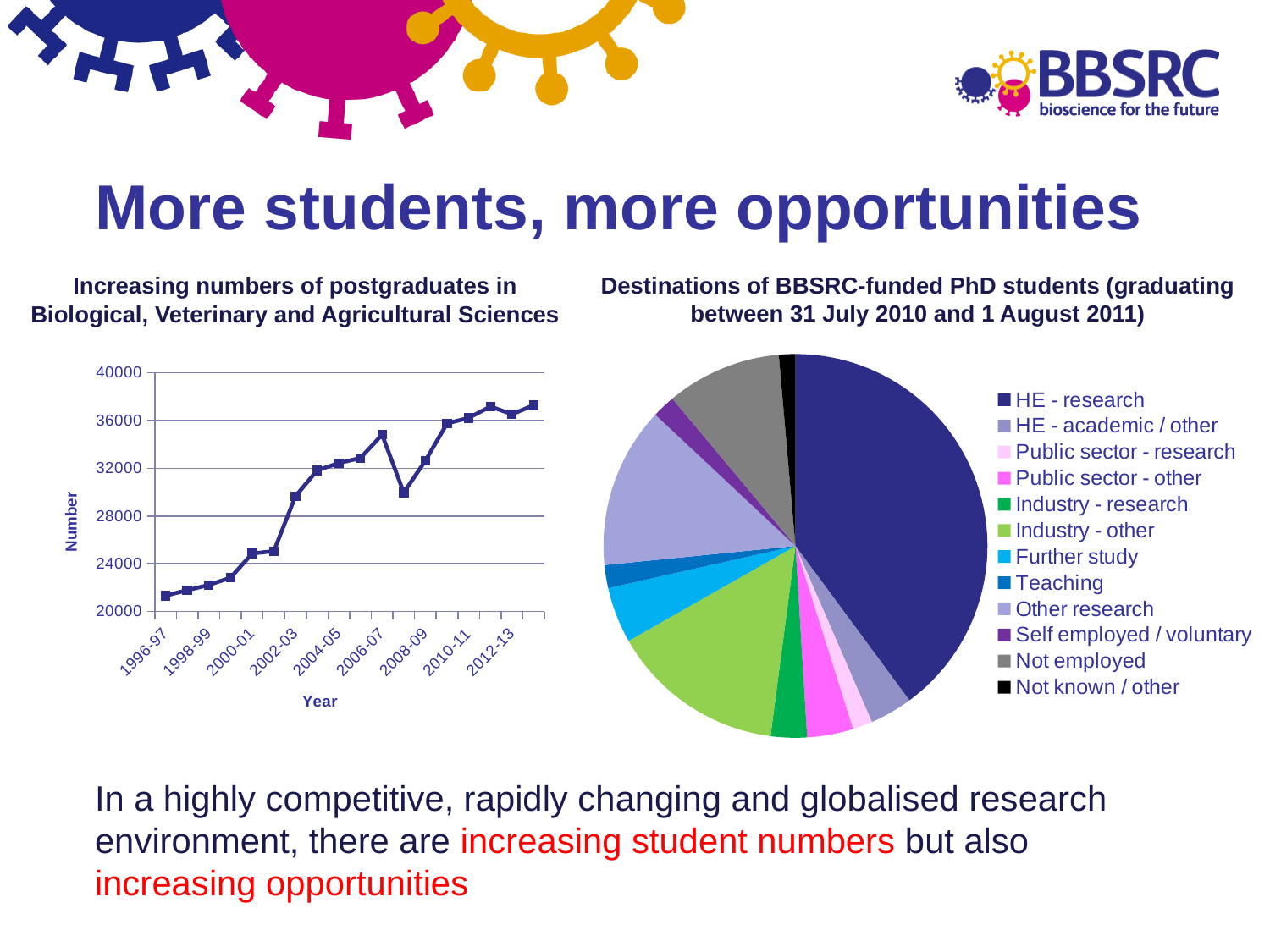
In the line chart on the left, is the value for 2012-13 greater or less than 36000? greater In the pie chart on the right, which category has the smallest slice? Not known / other In the pie chart on the right, which slice is larger, 'Industry - research' or 'Industry - other'? Industry - other What kind of chart is the chart titled 'Increasing numbers of postgraduates in Biological, Veterinary and Agricultural Sciences'? line chart In the pie chart on the right, which category has the largest slice? HE - research In the line chart on the left, what is the label of the y axis? Number In the line chart on the left, is the value for 2006-07 greater or less than 32000? greater In the line chart on the left, do the values generally rise or fall from 1996-97 to 2012-13? rise What kind of chart is the chart titled 'Destinations of BBSRC-funded PhD students'? pie chart How many categories does the legend of the pie chart on the right list? 12 In the line chart on the left, is the value for 1996-97 greater or less than 24000? less In the line chart on the left, which is larger, the value for 1996-97 or the value for 2012-13? 2012-13